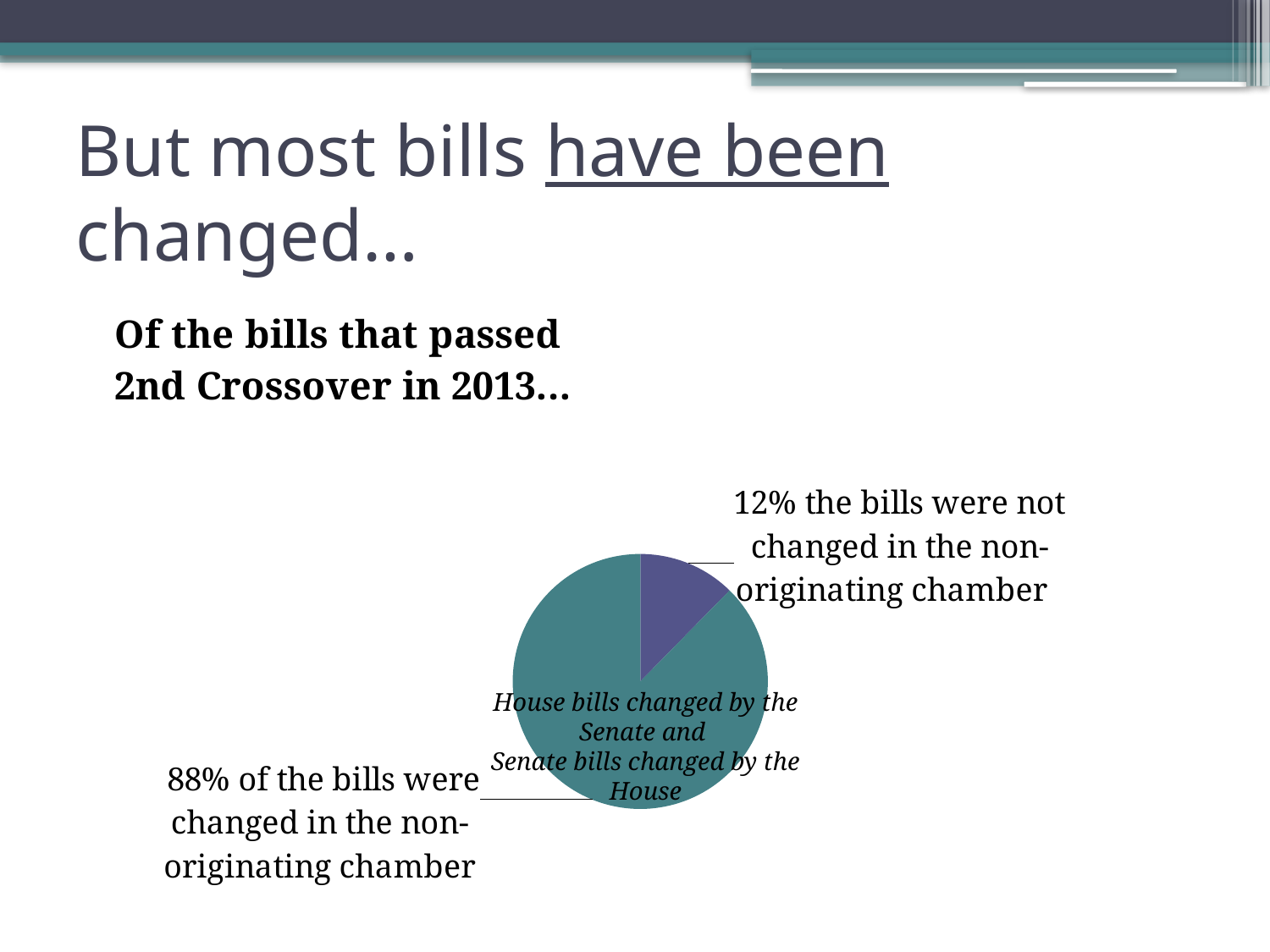
What is the difference in percentage points between the share of bills changed and the share not changed in the non-originating chamber? 76 What do the two slices of the pie chart add up to? 100% Which slice of the pie chart is the largest? bills changed in the non-originating chamber (88%) What label is printed inside the large slice of the pie chart? House bills changed by the Senate and Senate bills changed by the House Which slice of the pie chart is the smallest? bills not changed in the non-originating chamber (12%) Is the share of bills not changed in the non-originating chamber greater or less than 50%? less What kind of chart is shown on the slide? pie chart How many slices does the pie chart have? 2 What share of the bills were not changed in the non-originating chamber? 12% What share of the bills were changed in the non-originating chamber? 88% Which slice of the pie chart is larger: bills changed in the non-originating chamber or bills not changed? bills changed in the non-originating chamber What colour is the slice representing the 12% of bills that were not changed? purple